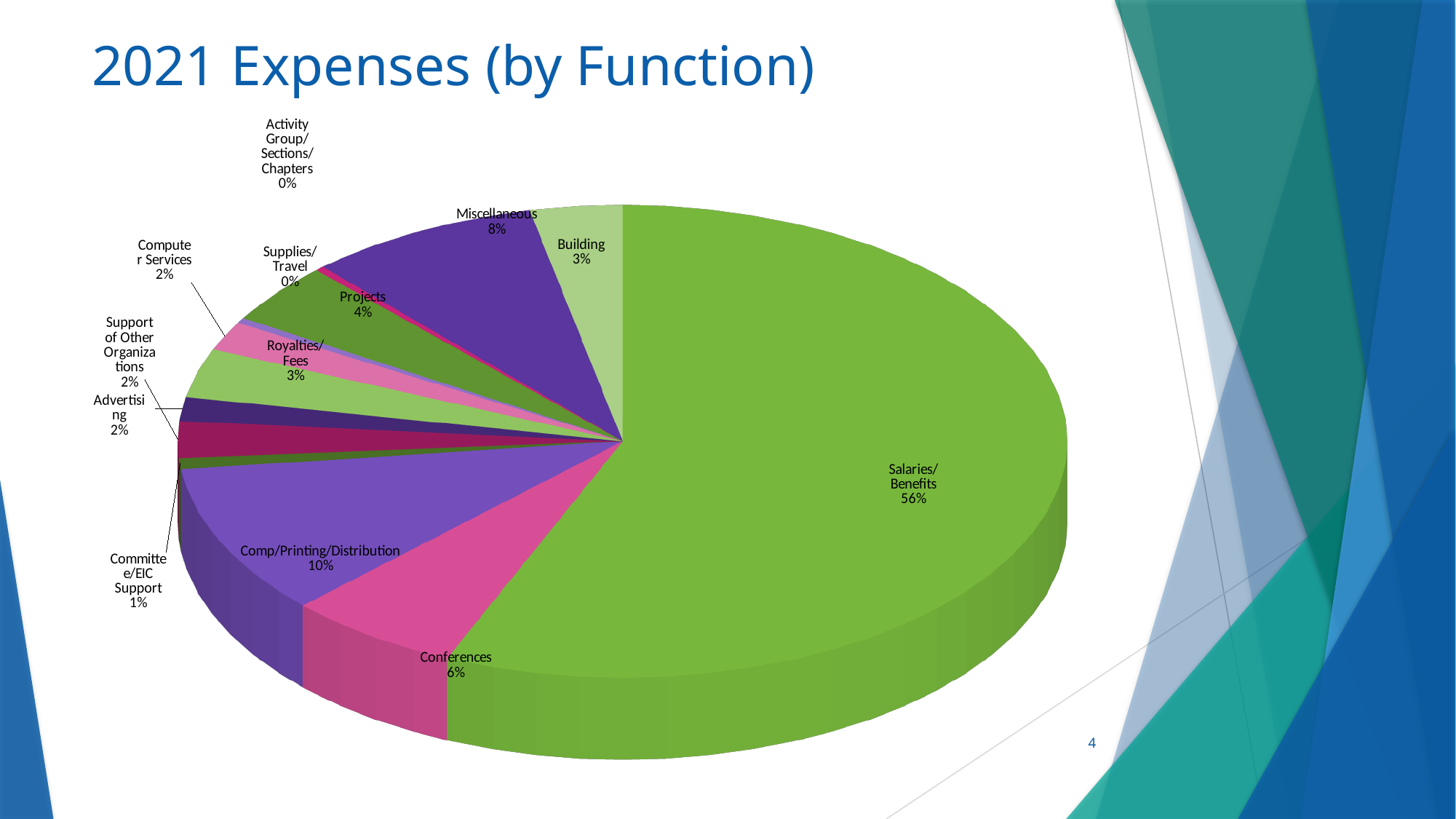
Which category accounts for the largest share of expenses? Salaries/Benefits What is the difference in percentage points between Comp/Printing/Distribution and Conferences? 4 What percentage of expenses is Conferences? 6% What percentage of expenses is Royalties/Fees? 3% Which is larger, the share for Projects or the share for Building? Projects What percentage of expenses is Committee/EIC Support? 1% What share of 2021 expenses is Salaries/Benefits? 56% What percentage of expenses is Comp/Printing/Distribution? 10% How many categories are shown in the pie chart? 13 What percentage of expenses is Miscellaneous? 8% What is the title of the chart? 2021 Expenses (by Function) What kind of chart is shown on the slide? pie chart